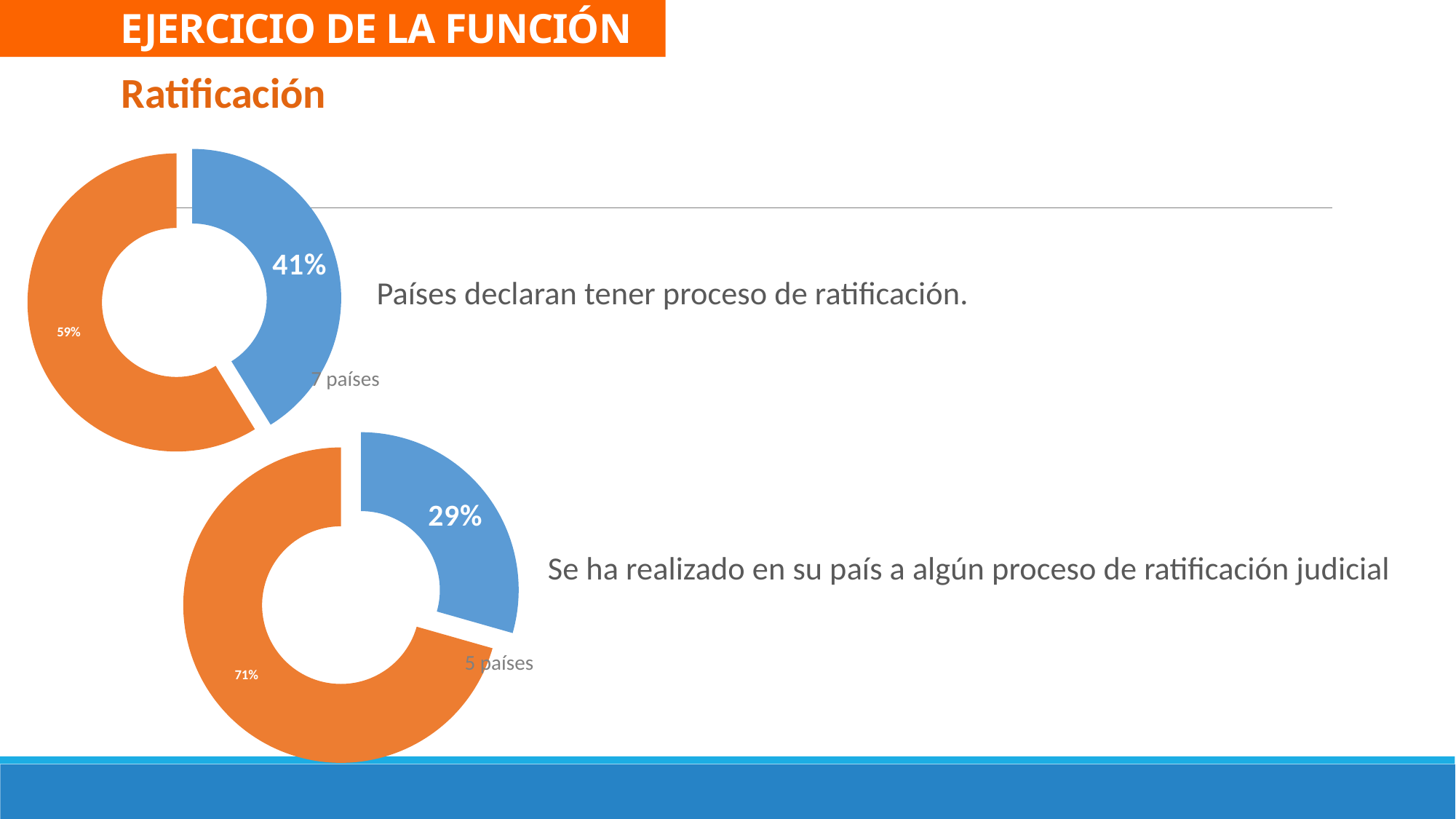
In the top chart (next to 'Países declaran tener proceso de ratificación.'), what percentage does the blue slice show? 41% What number of countries is written next to the blue slice of the top chart? 7 países In the bottom chart, which slice is smaller, the blue one or the orange one? blue In the bottom chart (next to 'Se ha realizado en su país a algún proceso de ratificación judicial'), what percentage does the blue slice show? 29% In the bottom chart, what is the difference between the orange slice and the blue slice? 42% What number of countries is written next to the blue slice of the bottom chart? 5 países How many slices does each chart on the slide have? 2 In the top chart, what is the difference between the orange slice and the blue slice? 18% In the bottom chart, what percentage does the orange slice show? 71% What kind of chart is used on this slide? doughnut (pie) chart In the top chart, which slice is larger, the blue one or the orange one? orange In the top chart, what percentage does the orange slice show? 59%